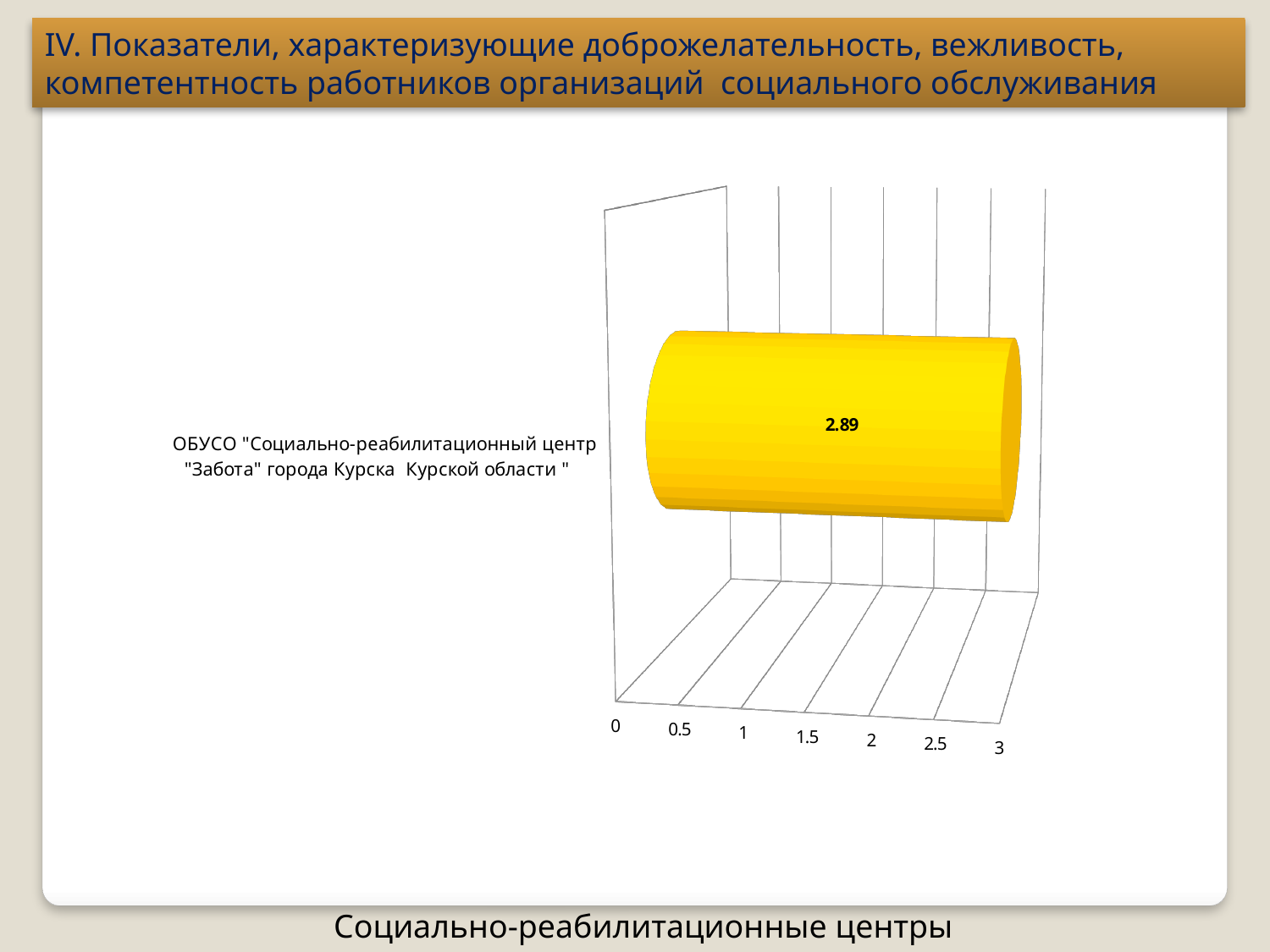
What is the maximum value shown on the chart's value axis? 3 Which category has the highest value in the chart? ОБУСО "Социально-реабилитационный центр "Забота" города Курска Курской области" What colour is the bar in the chart? yellow Is the value for ОБУСО "Социально-реабилитационный центр "Забота" greater or less than 3? less What value is shown for ОБУСО "Социально-реабилитационный центр "Забота" города Курска Курской области"? 2.89 Is the value for ОБУСО "Социально-реабилитационный центр "Забота" greater or less than 2.5? greater What kind of chart is shown on the slide? bar chart How many categories are plotted in the chart? 1